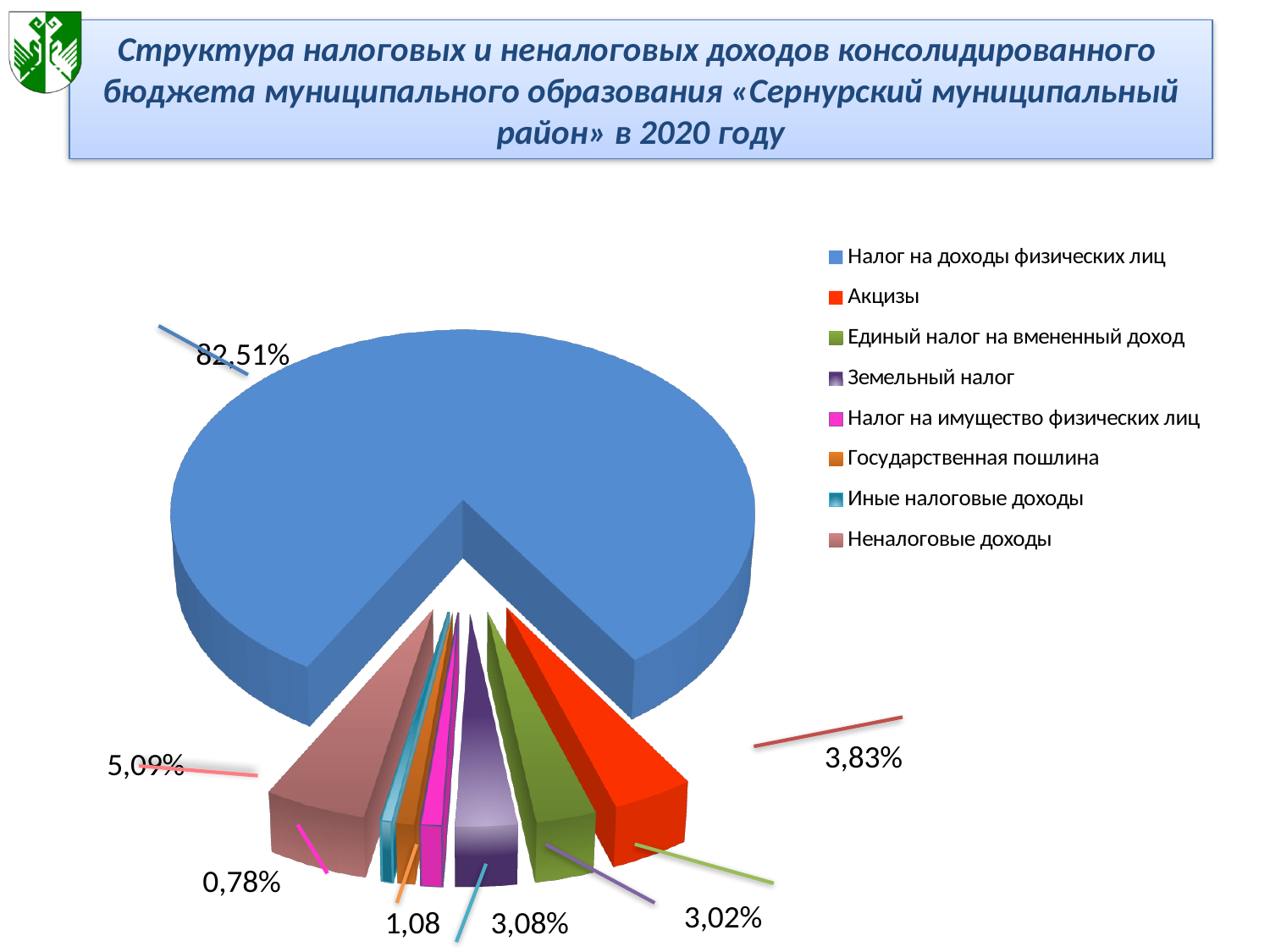
Which is larger: Налог на доходы физических лиц or Налог на имущество физических лиц? Налог на доходы физических лиц What is the smallest percentage label printed on the chart? 0,78% What share of the pie does Налог на доходы физических лиц have? 82,51% Which category is listed first in the legend? Налог на доходы физических лиц What value is shown for Налог на имущество физических лиц? 0,78% What type of chart is shown on the slide? pie chart How many categories does the legend list? 8 What value is shown for Государственная пошлина? 1,08 Which category has the largest slice of the pie? Налог на доходы физических лиц What is the difference between the values for Налог на доходы физических лиц and Налог на имущество физических лиц? 81,73% What colour is the largest slice of the pie? blue How many data labels are printed on the pie chart? 7